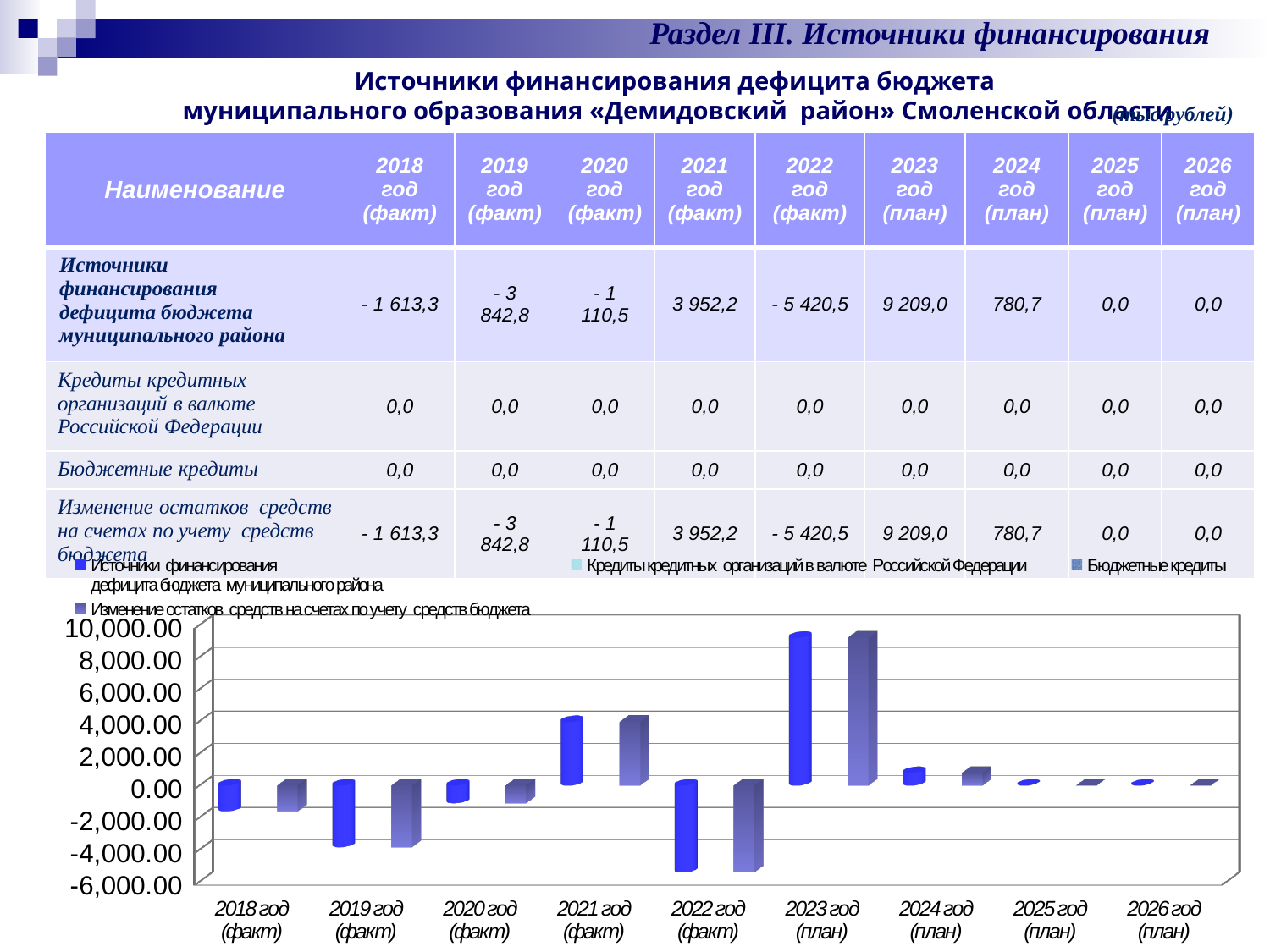
Is the value for 2021 год (факт) in the chart greater or less than 2,000.00? greater What is the value of 'Источники финансирования дефицита бюджета муниципального района' for 2023 год (план)? 9 209,0 Which is larger in the chart, the value for 2021 год (факт) or the value for 2024 год (план)? 2021 год (факт) Is the value for 2023 год (план) in the chart greater or less than 8,000.00? greater How many year categories are shown along the x axis of the chart? 9 How many series does the chart's legend list? 4 What is the difference between the 'Источники финансирования дефицита бюджета муниципального района' values for 2023 год (план) and 2024 год (план)? 8 428,3 What kind of chart is shown at the bottom of the slide? bar chart Do the values in the chart rise or fall from 2024 год (план) to 2026 год (план)? fall Is the value for 2022 год (факт) in the chart greater or less than -4,000.00? less Which year has the highest bars in the chart? 2023 год (план) Which year has the lowest (most negative) bars in the chart? 2022 год (факт)